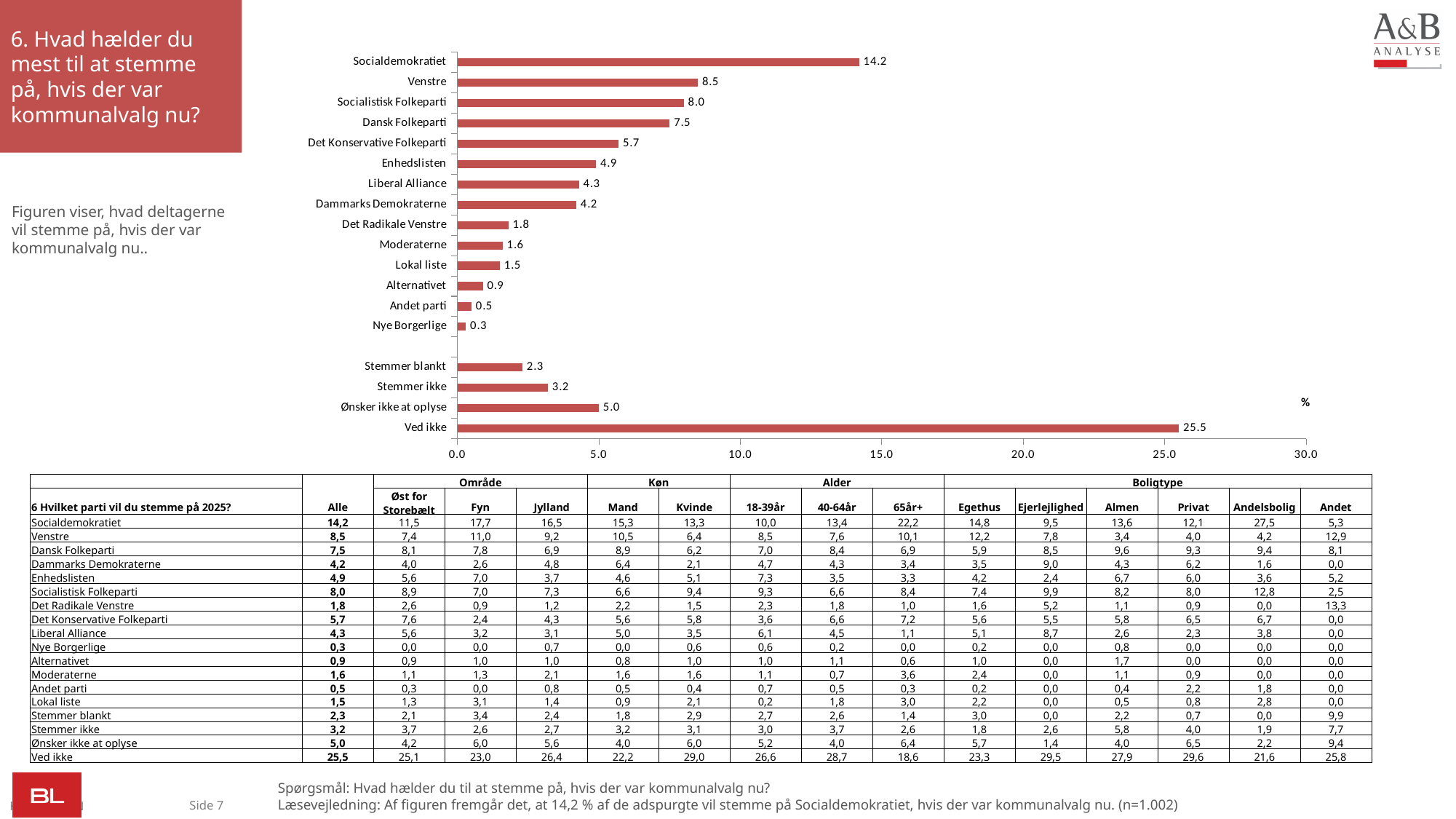
What is the difference between the values for Socialdemokratiet and Venstre? 5.7 What is the value for Venstre in the chart? 8.5 What is the value for Socialdemokratiet in the chart? 14.2 What kind of chart is shown on the slide? bar chart What is the value for Ved ikke in the chart? 25.5 Is the value for Socialdemokratiet greater or less than 10.0? greater Which category has the lowest value in the chart? Nye Borgerlige What is the maximum value shown on the horizontal axis of the chart? 30.0 What is the value for Det Konservative Folkeparti in the chart? 5.7 How many bars are plotted in the chart? 18 Which has a larger value, Enhedslisten or Liberal Alliance? Enhedslisten Which category has the highest value in the chart? Ved ikke